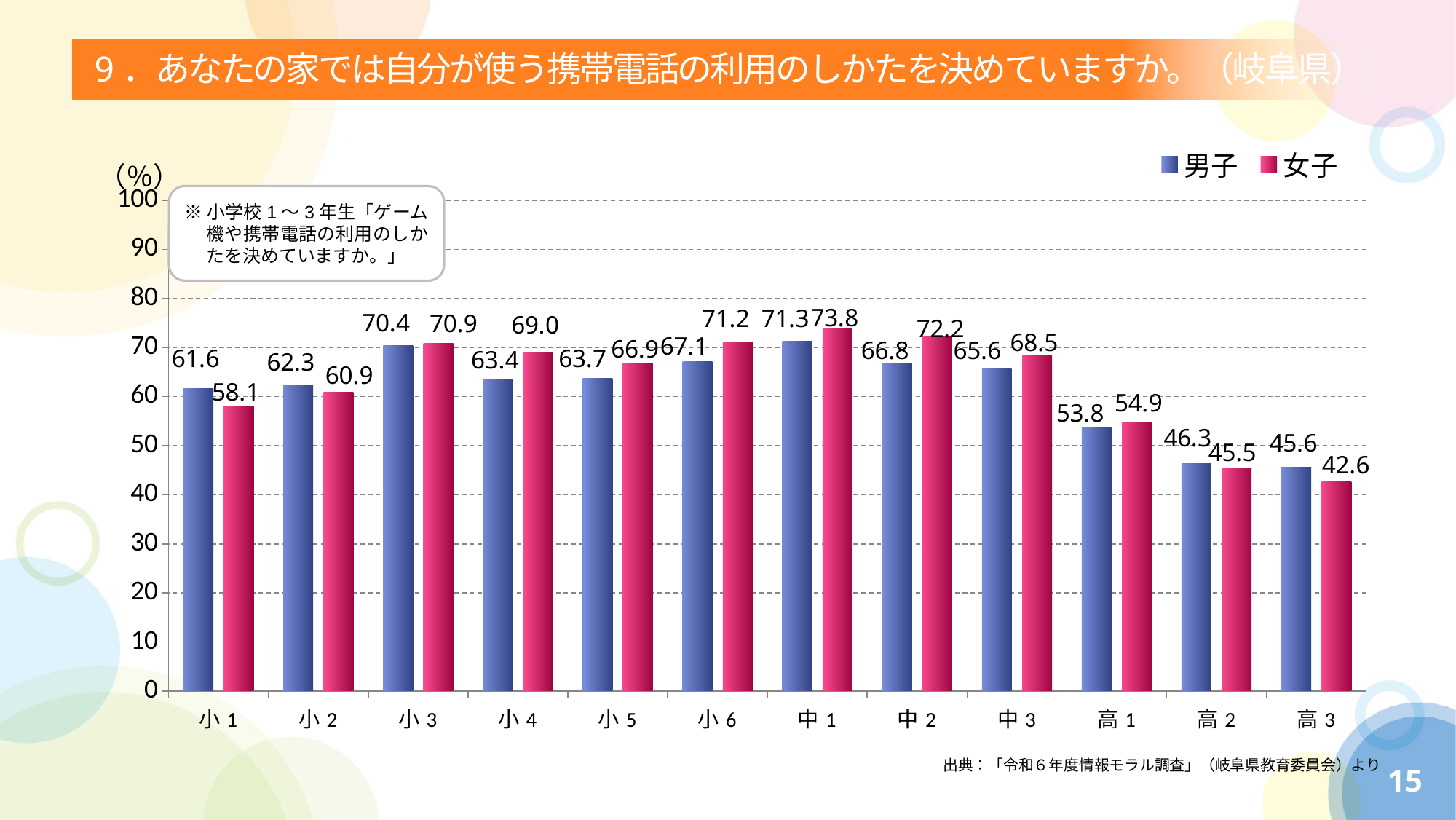
Which category has the highest value for 女子? 中1 What kind of chart is shown on the slide? bar chart What is the value for 男子 in the 中1 category? 71.3 Which category has the lowest value for 男子? 高3 What is the value for 女子 in the 小4 category? 69.0 How many categories are shown on the x axis? 12 Do the 女子 values rise or fall from 中1 to 高3? fall How many series does the legend list? 2 What is the difference between the 女子 and 男子 values in the 中2 category? 5.4 What is the value for 男子 in the 高2 category? 46.3 In the 小1 category, which is larger, the 男子 value or the 女子 value? 男子 Which category has the lowest value for 女子? 高3